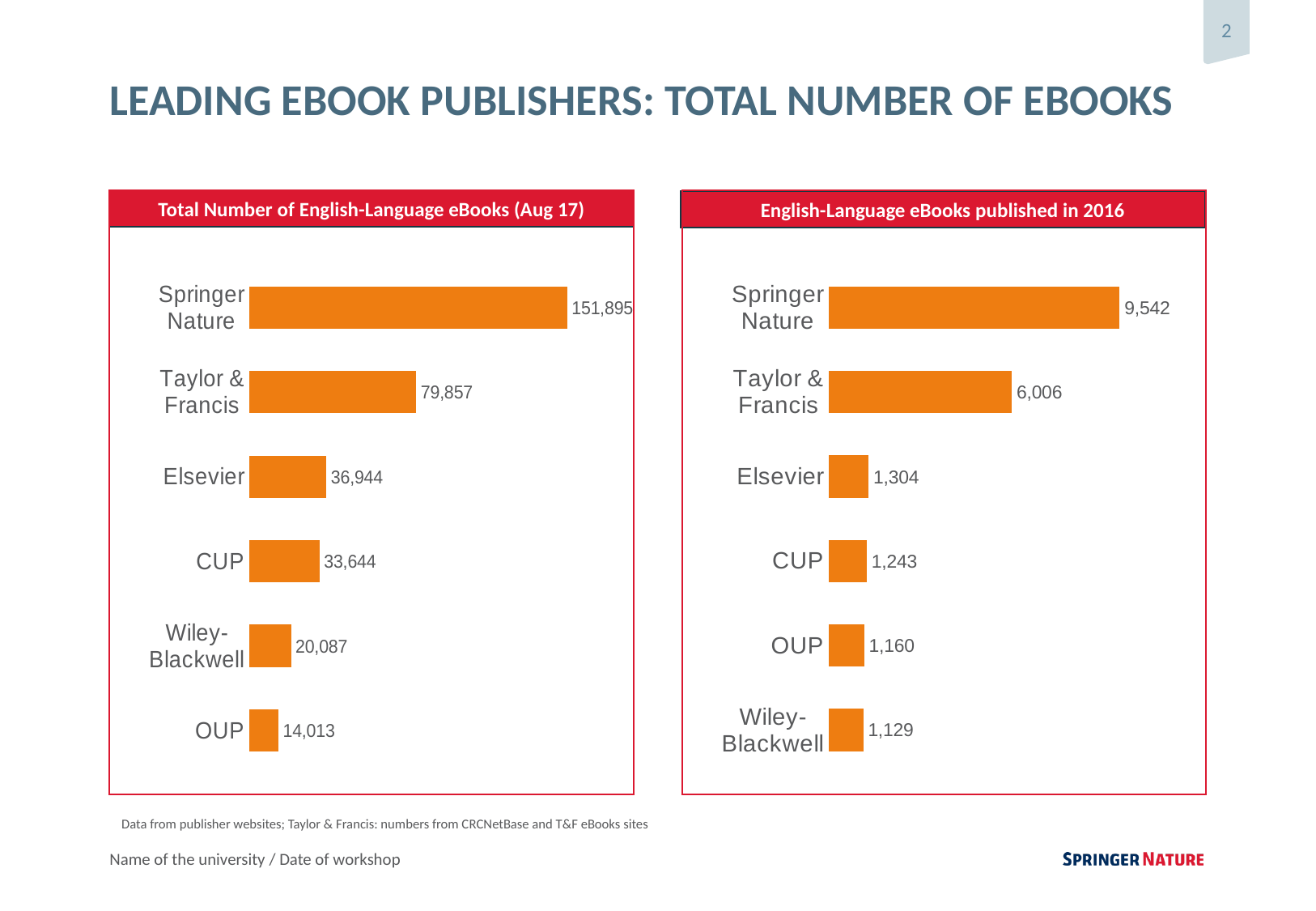
In the 'English-Language eBooks published in 2016' chart, which publisher has the lowest value? Wiley-Blackwell In the 'Total Number of English-Language eBooks (Aug 17)' chart, which publisher has the highest value? Springer Nature In the 'English-Language eBooks published in 2016' chart, which is larger, OUP or Wiley-Blackwell? OUP What kind of chart is the 'English-Language eBooks published in 2016' chart? Bar chart In the 'Total Number of English-Language eBooks (Aug 17)' chart, what is the value for Wiley-Blackwell? 20,087 In the 'Total Number of English-Language eBooks (Aug 17)' chart, what is the difference between Springer Nature and Taylor & Francis? 72,038 In the 'Total Number of English-Language eBooks (Aug 17)' chart, what is the value for Taylor & Francis? 79,857 In the 'Total Number of English-Language eBooks (Aug 17)' chart, which publisher has the lowest value? OUP In the 'English-Language eBooks published in 2016' chart, what is the value for Elsevier? 1,304 In the 'Total Number of English-Language eBooks (Aug 17)' chart, which is larger, Elsevier or CUP? Elsevier In the 'English-Language eBooks published in 2016' chart, what is the difference between Springer Nature and Taylor & Francis? 3,536 How many publishers are shown in the 'Total Number of English-Language eBooks (Aug 17)' chart? 6